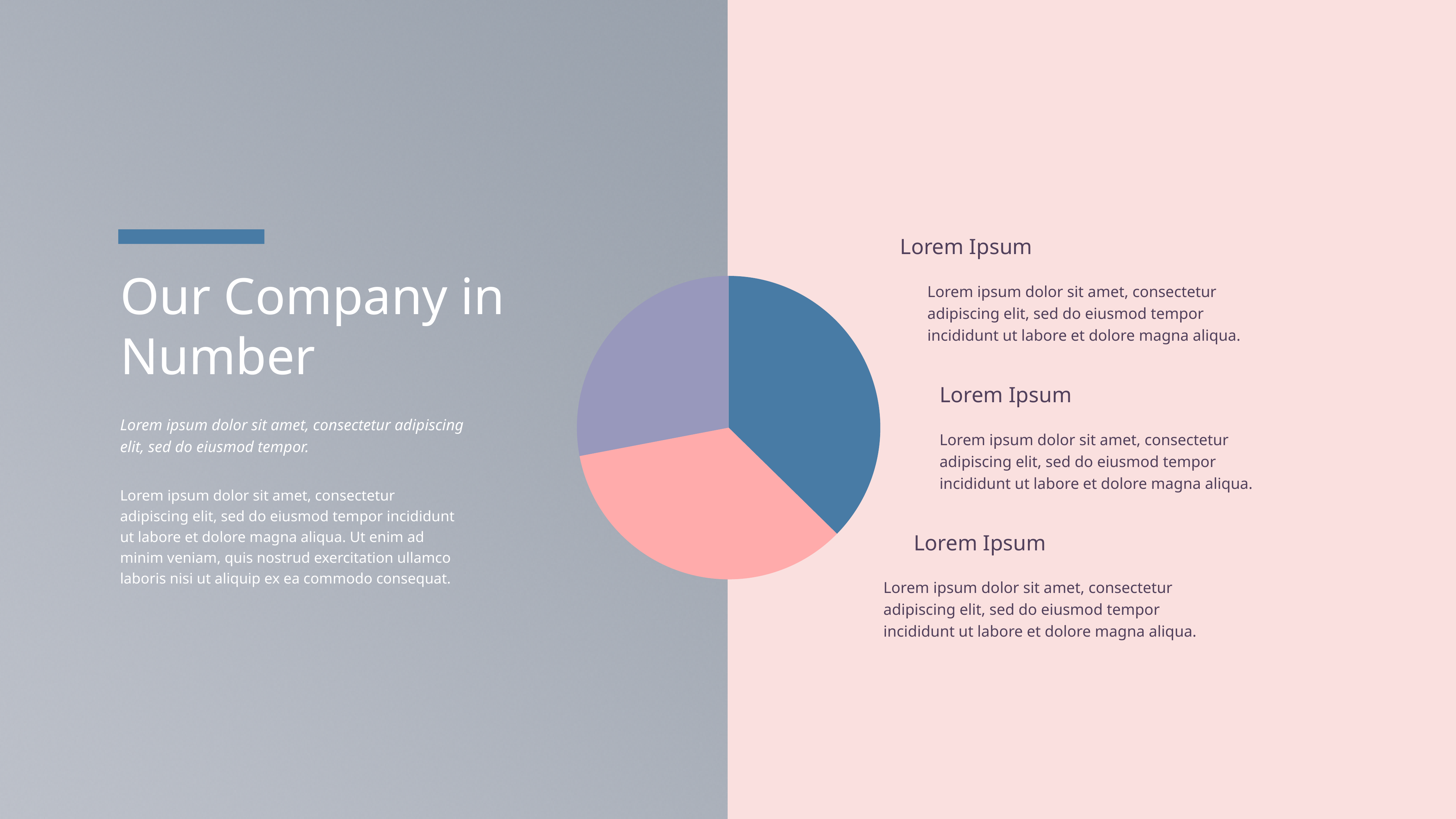
Which is larger in the pie chart, the blue slice or the purple slice? the blue slice How many slices does the pie chart have? 3 Which slice of the pie chart is the largest? the blue slice What colours are the three slices of the pie chart? blue, pink and purple What kind of chart is shown on the slide? pie chart Does the pie chart display any data labels or percentages on its slices? No